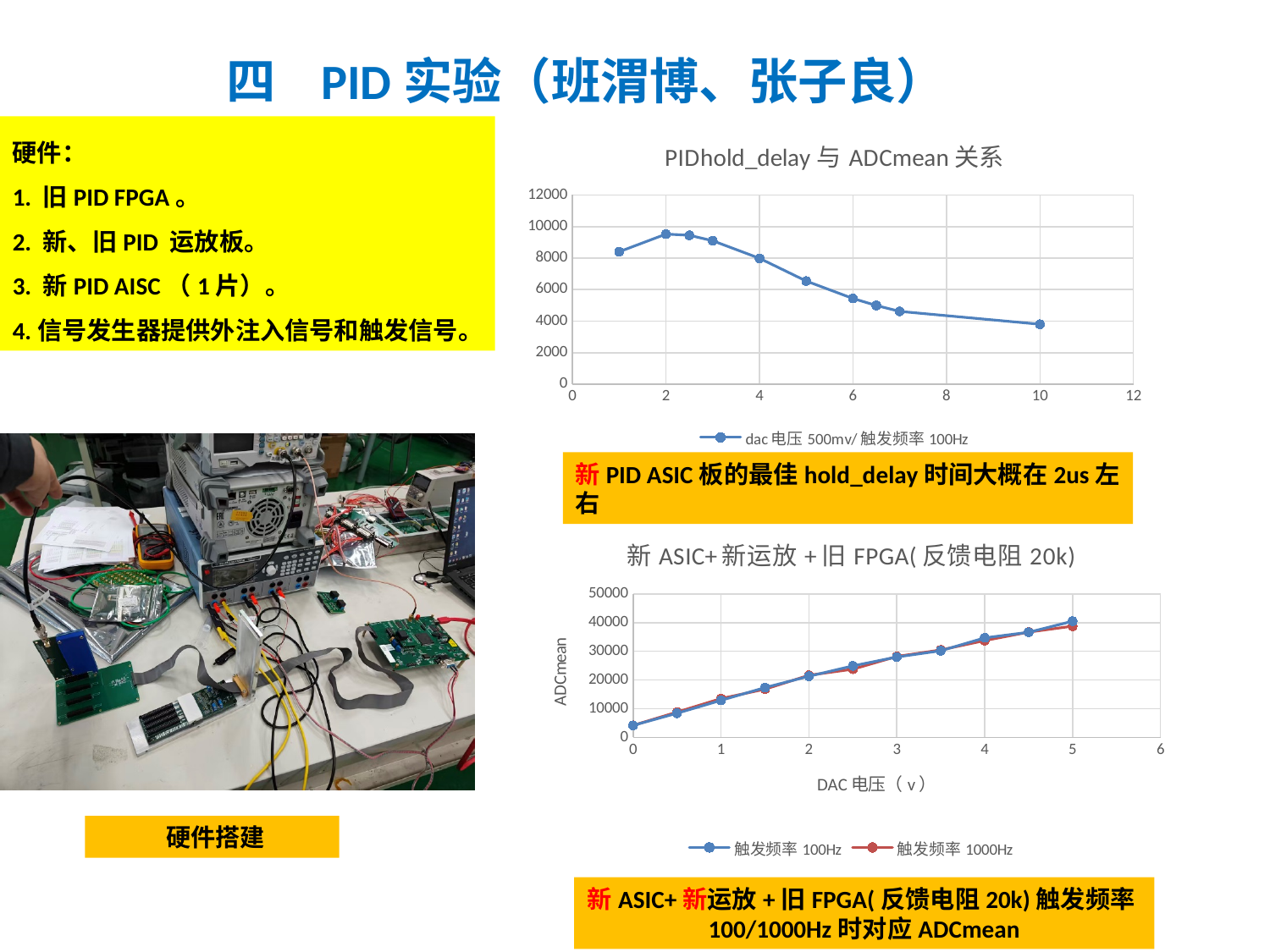
In the bottom chart "新 ASIC+新运放 +旧 FPGA( 反馈电阻 20k)", how many data points does the 触发频率 100Hz series have? 11 In the bottom chart "新 ASIC+新运放 +旧 FPGA( 反馈电阻 20k)", what is the label of the y axis? ADCmean What kind of chart is the top chart titled "PIDhold_delay 与 ADCmean 关系"? line chart In the bottom chart "新 ASIC+新运放 +旧 FPGA( 反馈电阻 20k)", is the 触发频率 100Hz value at DAC 电压 3 greater or less than 20000? greater In the top chart "PIDhold_delay 与 ADCmean 关系", which has the larger value, x = 4 or x = 6? x = 4 In the top chart "PIDhold_delay 与 ADCmean 关系", at which x value is the plotted value lowest? 10 In the bottom chart "新 ASIC+新运放 +旧 FPGA( 反馈电阻 20k)", how many series does the legend list? 2 In the bottom chart "新 ASIC+新运放 +旧 FPGA( 反馈电阻 20k)", do the ADCmean values rise or fall as DAC 电压 increases? rise In the top chart "PIDhold_delay 与 ADCmean 关系", what is the legend entry for the plotted series? dac 电压 500mv/ 触发频率 100Hz In the top chart "PIDhold_delay 与 ADCmean 关系", how many data points are plotted? 10 In the top chart "PIDhold_delay 与 ADCmean 关系", is the value at x = 1 greater or less than 8000? greater